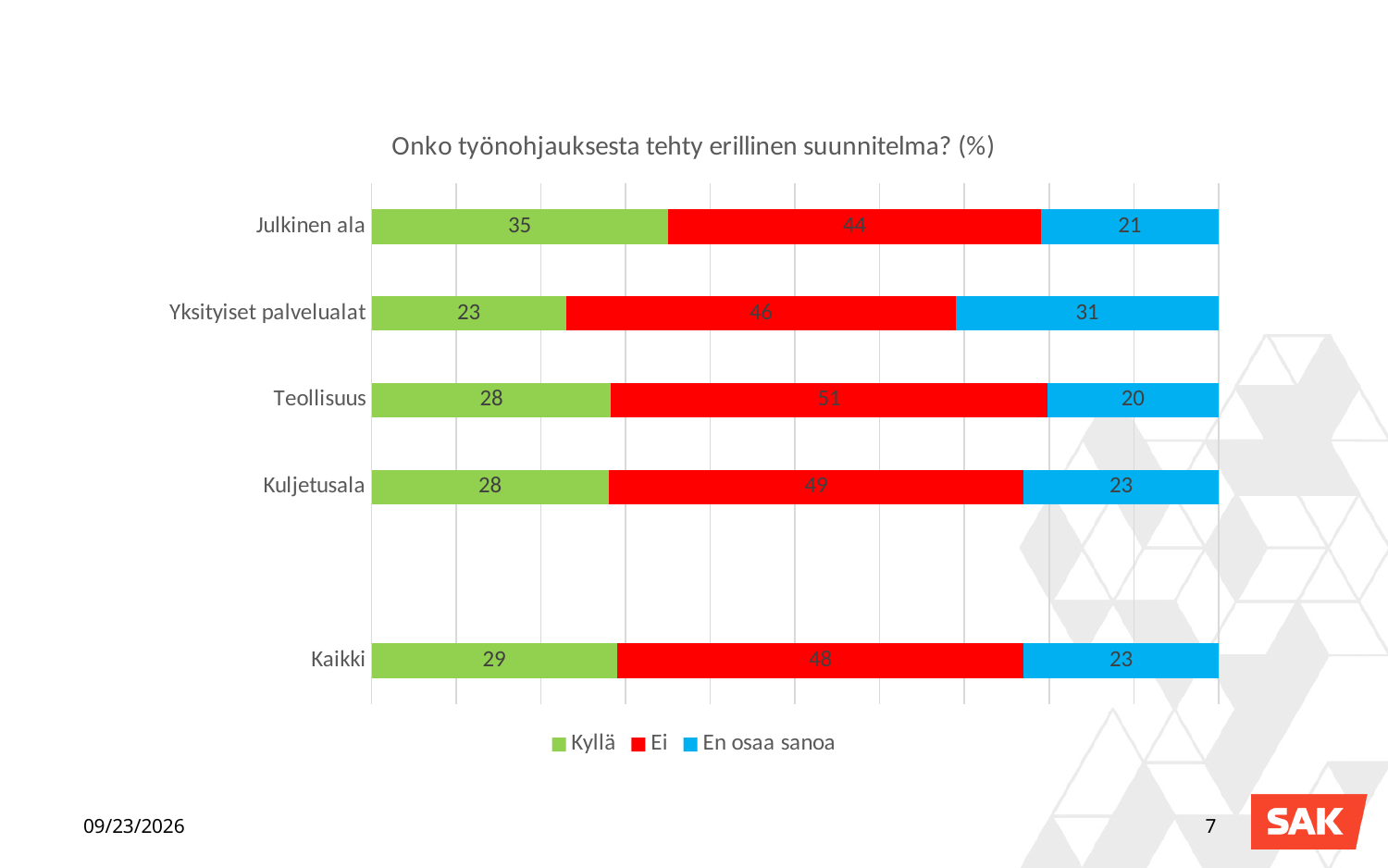
How many series does the legend list? 3 What is the En osaa sanoa value for Yksityiset palvelualat? 31 Which is larger, the En osaa sanoa value for Julkinen ala or for Yksityiset palvelualat? Yksityiset palvelualat What is the Kyllä value for Julkinen ala? 35 How many categories are shown on the chart? 5 What kind of chart is shown on the slide? Stacked bar chart What is the title of the chart? Onko työnohjauksesta tehty erillinen suunnitelma? (%) Which category has the highest Ei value? Teollisuus What is the difference between the Ei value and the Kyllä value for Kaikki? 19 What is the total of the stacked bar for Kuljetusala? 100 What is the Ei value for Teollisuus? 51 Which category has the lowest Kyllä value? Yksityiset palvelualat